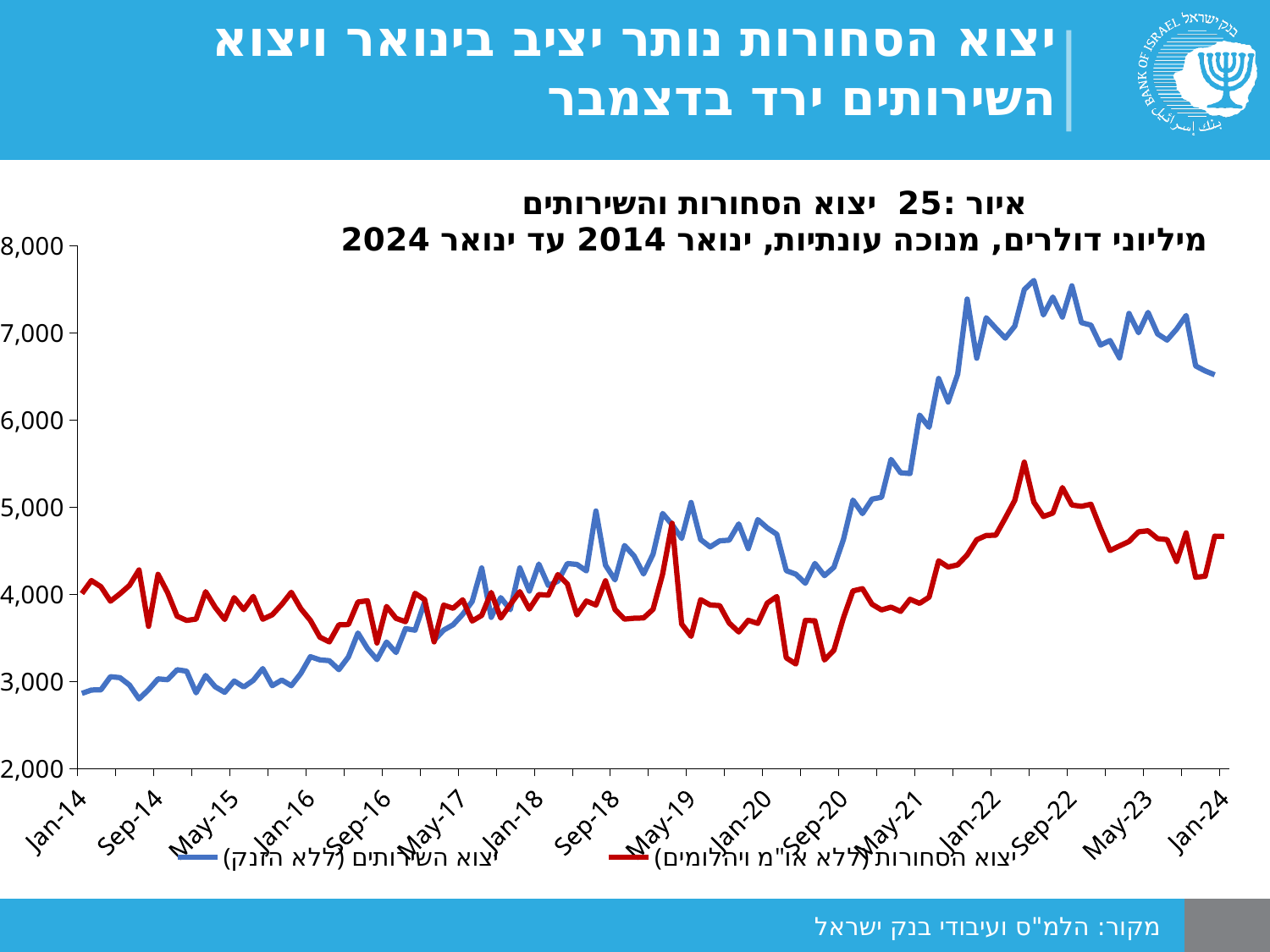
Is the highest value reached by the services exports series (blue line) greater or less than 7,000? greater Is the highest value reached by the goods exports series (red line) greater or less than 5,000? greater What is the figure number given in the chart title? איור 25 At Jan-24, which series is higher: services exports (blue) or goods exports (red)? services exports (blue) Is the value of the services exports series (blue line) at Jan-24 greater or less than 6,000? greater What colour is the line for יצוא השירותים (ללא הזנק) in the legend? blue What kind of chart is shown on the slide? line chart Does the services exports series (blue line) generally rise or fall between Jan-14 and Jan-22? rise How many series does the legend list? 2 At Jan-14, which series is higher: services exports (blue) or goods exports (red)? goods exports (red)